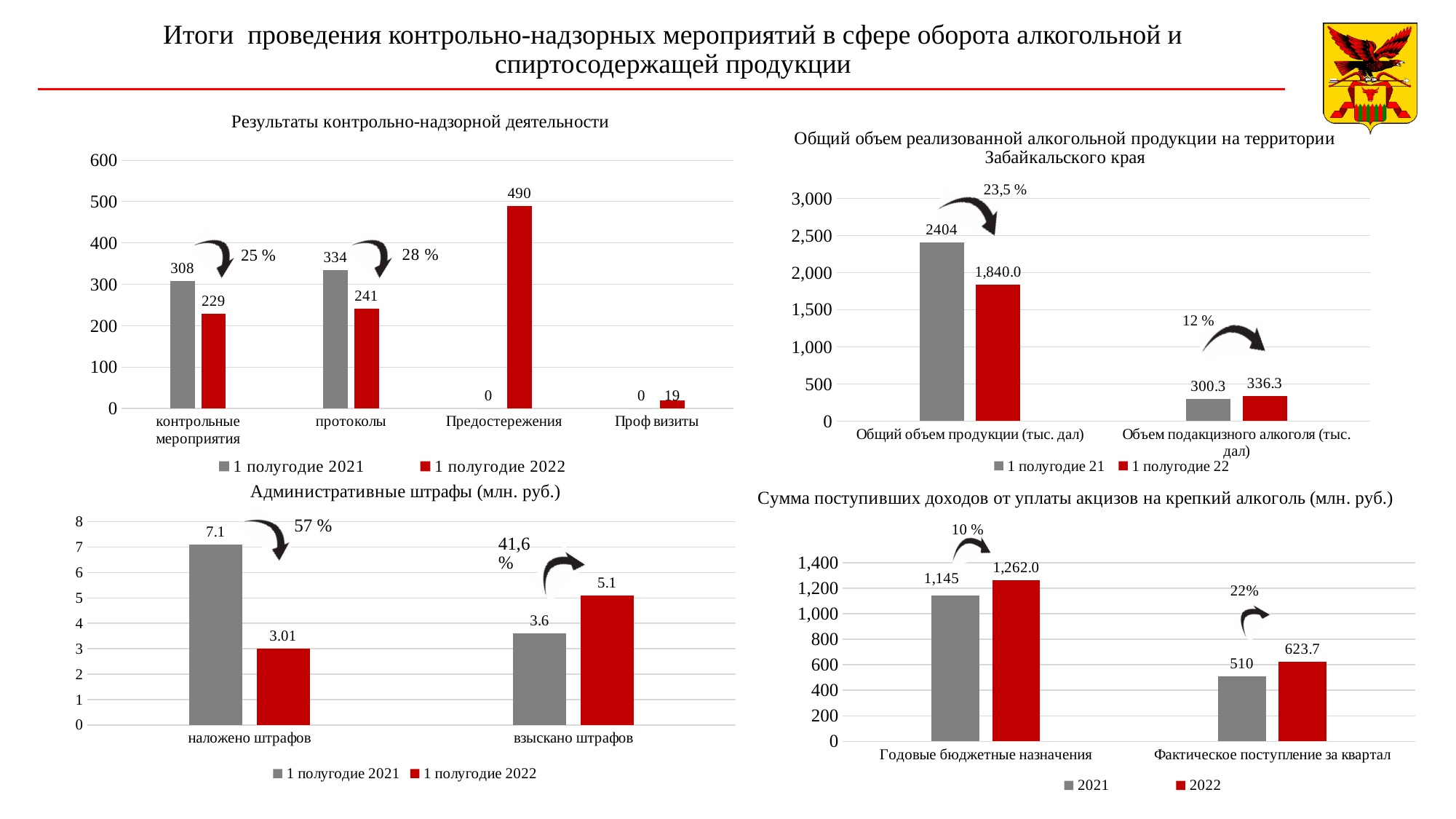
In the chart 'Общий объем реализованной алкогольной продукции на территории Забайкальского края', which is larger for 'Объем подакцизного алкоголя (тыс. дал)': '1 полугодие 21' or '1 полугодие 22'? 1 полугодие 22 In the chart 'Сумма поступивших доходов от уплаты акцизов на крепкий алкоголь (млн. руб.)', which category has the lowest value in the series '2021'? Фактическое поступление за квартал How many series does the legend list in the chart 'Общий объем реализованной алкогольной продукции на территории Забайкальского края'? 2 In the chart 'Общий объем реализованной алкогольной продукции на территории Забайкальского края', what is the value for 'Общий объем продукции (тыс. дал)' in the series '1 полугодие 22'? 1,840.0 In the chart 'Сумма поступивших доходов от уплаты акцизов на крепкий алкоголь (млн. руб.)', what is the value for 'Фактическое поступление за квартал' in the series '2022'? 623.7 In the chart 'Административные штрафы (млн. руб.)', what is the difference between the '1 полугодие 2022' and '1 полугодие 2021' values for 'взыскано штрафов'? 1.5 What kind of chart is 'Административные штрафы (млн. руб.)'? bar chart In the chart 'Результаты контрольно-надзорной деятельности', what is the difference between the '1 полугодие 2021' and '1 полугодие 2022' values for 'контрольные мероприятия'? 79 In the chart 'Результаты контрольно-надзорной деятельности', what is the value for 'протоколы' in the series '1 полугодие 2021'? 334 In the chart 'Результаты контрольно-надзорной деятельности', which category has the highest value in the series '1 полугодие 2022'? Предостережения In the chart 'Административные штрафы (млн. руб.)', what is the value for 'наложено штрафов' in the series '1 полугодие 2022'? 3.01 How many categories are shown on the x axis of the chart 'Результаты контрольно-надзорной деятельности'? 4